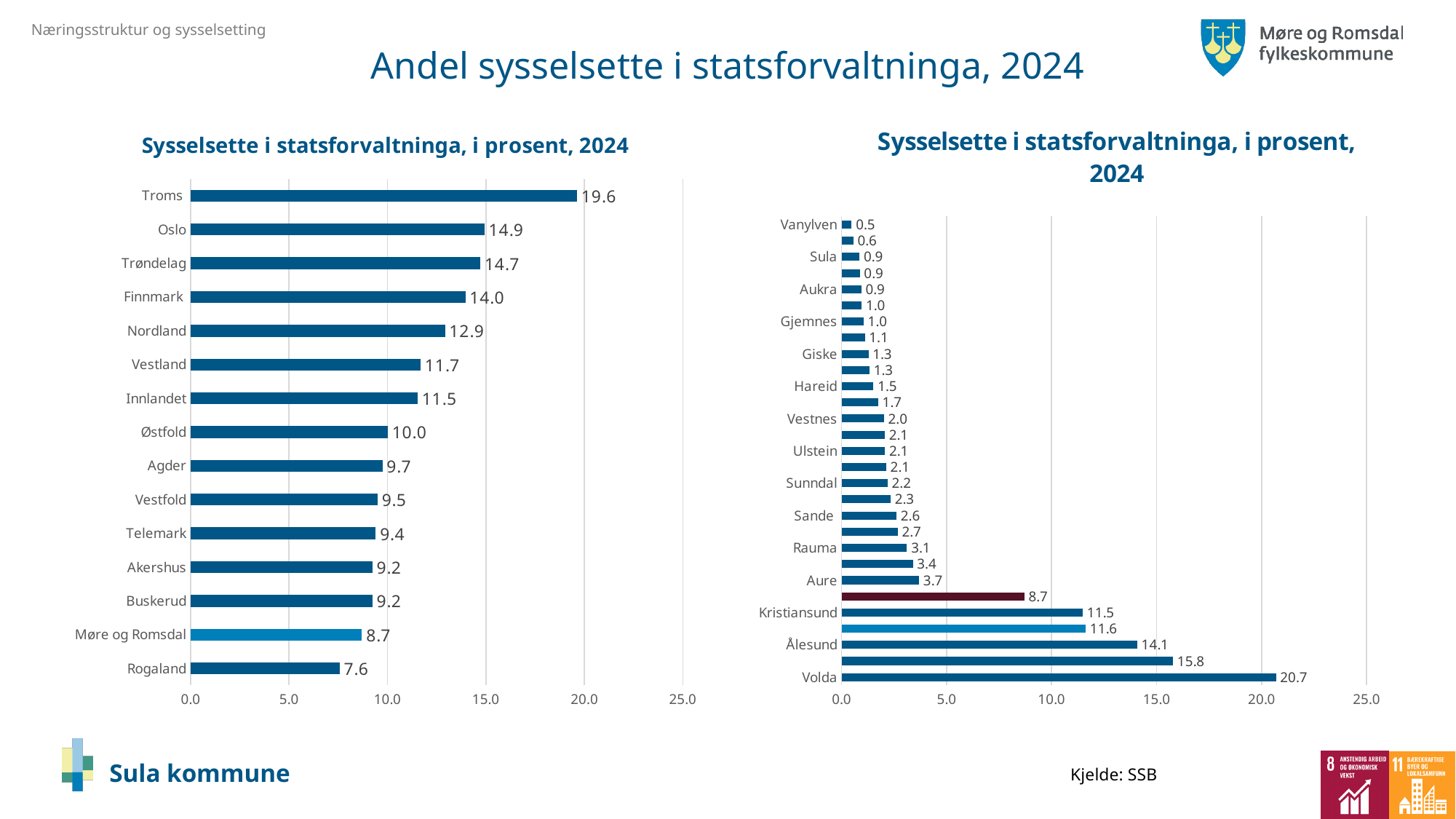
On the left chart, what is the value for Møre og Romsdal? 8.7 What type of chart is the left chart? Bar chart On the left chart, what is the value for Troms? 19.6 On the left chart, how many categories are shown? 15 On the right chart, which category has the highest value? Volda On the right chart, what is the value for Kristiansund? 11.5 On the left chart, which category has the lowest value? Rogaland On the left chart, what is the difference between Oslo and Trøndelag? 0.2 On the left chart, which is larger, Vestland or Innlandet? Vestland On the right chart, what is the value for Volda? 20.7 On the left chart, which bar is shown in a lighter blue colour than the others? Møre og Romsdal On the right chart, what is the difference between Ålesund and Aure? 10.4